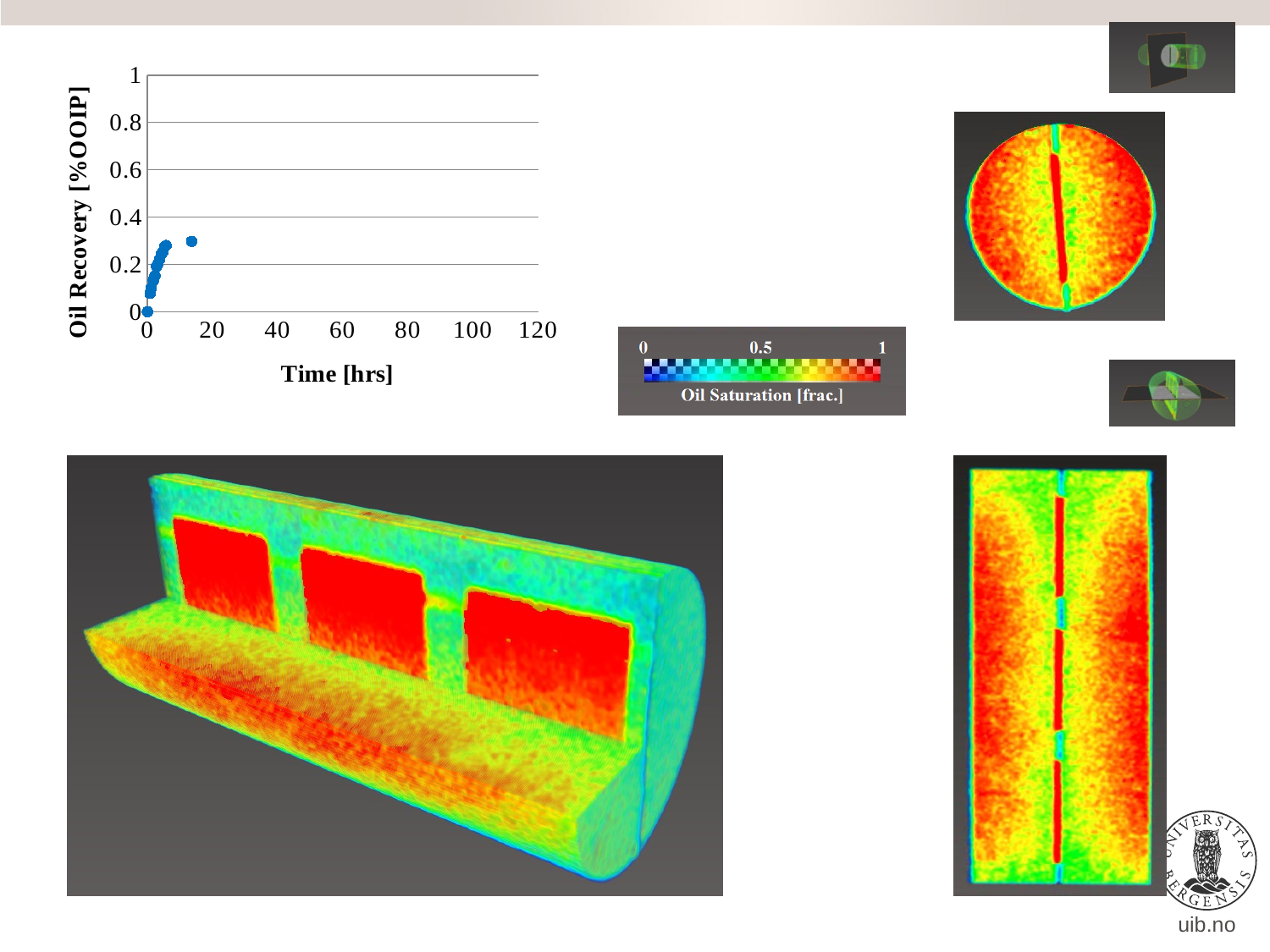
Is the oil recovery value at time 0 hrs greater or less than 0.2? less Is the highest oil recovery value plotted greater or less than 0.4? less Is the highest oil recovery value plotted greater or less than 0.2? greater What type of chart is shown on the slide? scatter chart What is the maximum value shown on the x axis of the chart? 120 What is the title of the y axis of the chart? Oil Recovery [%OOIP] Do the oil recovery values rise or fall as time increases along the x axis? rise What is the title of the x axis of the chart? Time [hrs]